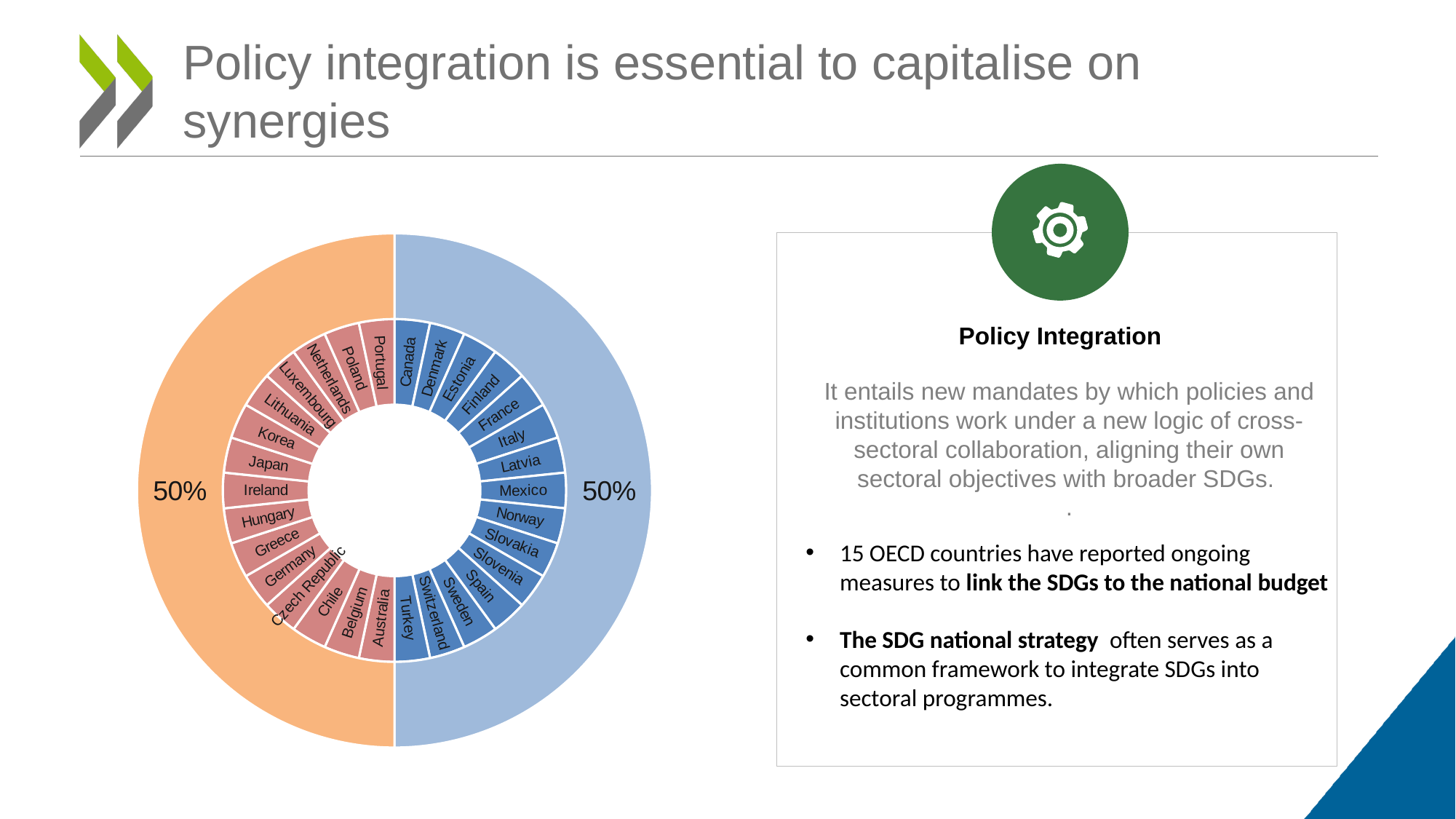
What kind of chart is shown on the left of the slide? Doughnut chart Is the orange segment of the outer ring larger or smaller than the blue segment, or are they equal? Equal What share of the outer ring does the orange segment represent? 50% Which colour is the inner-ring segment for Mexico? Blue Which colour is the inner-ring segment for Japan? Red How many countries are listed in the red half of the inner ring? 15 Is Germany in the blue half or the red half of the inner ring? Red half How many countries in total are shown in the inner ring of the chart? 30 How many segments make up the outer ring of the chart? 2 Is Canada in the blue half or the red half of the inner ring? Blue half What share of the outer ring does the blue segment represent? 50%